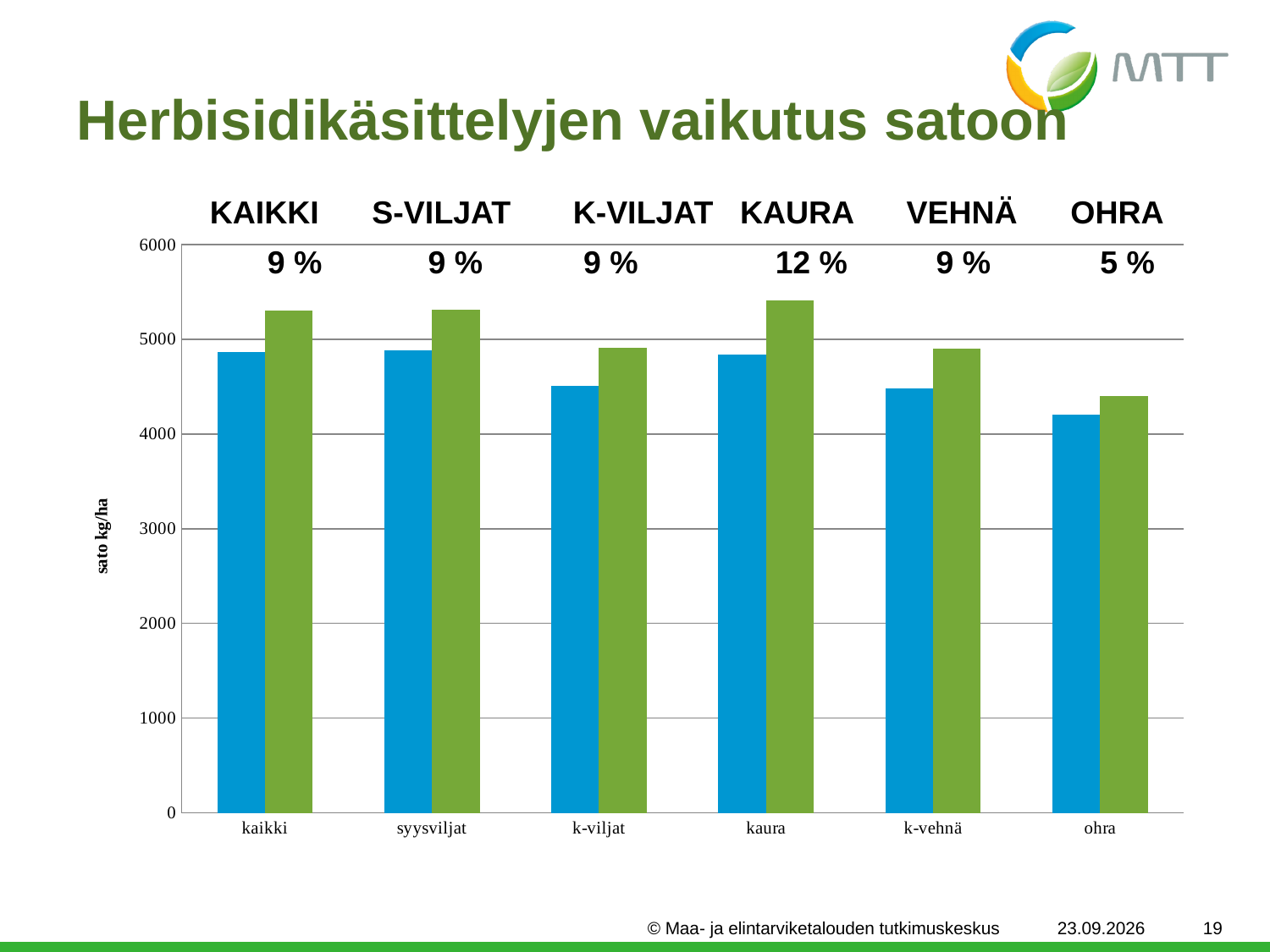
What percentage is printed above the OHRA group in the chart? 5 % Which group has the lowest percentage printed above it? OHRA How many categories are shown along the x axis of the chart? 6 Is the value of the blue bar for ohra greater or less than 5000? less Which group has the highest percentage printed above it? KAURA For kaura, which bar is taller, the blue bar or the green bar? the green bar What is the label on the y axis of the chart? sato kg/ha Which category has the lowest blue bar? ohra What kind of chart is shown on the slide? bar chart What is the difference between the percentage printed above KAURA and the percentage printed above OHRA? 7 % What percentage is printed above the KAURA group in the chart? 12 % Is the value of the green bar for kaura greater or less than 5000? greater